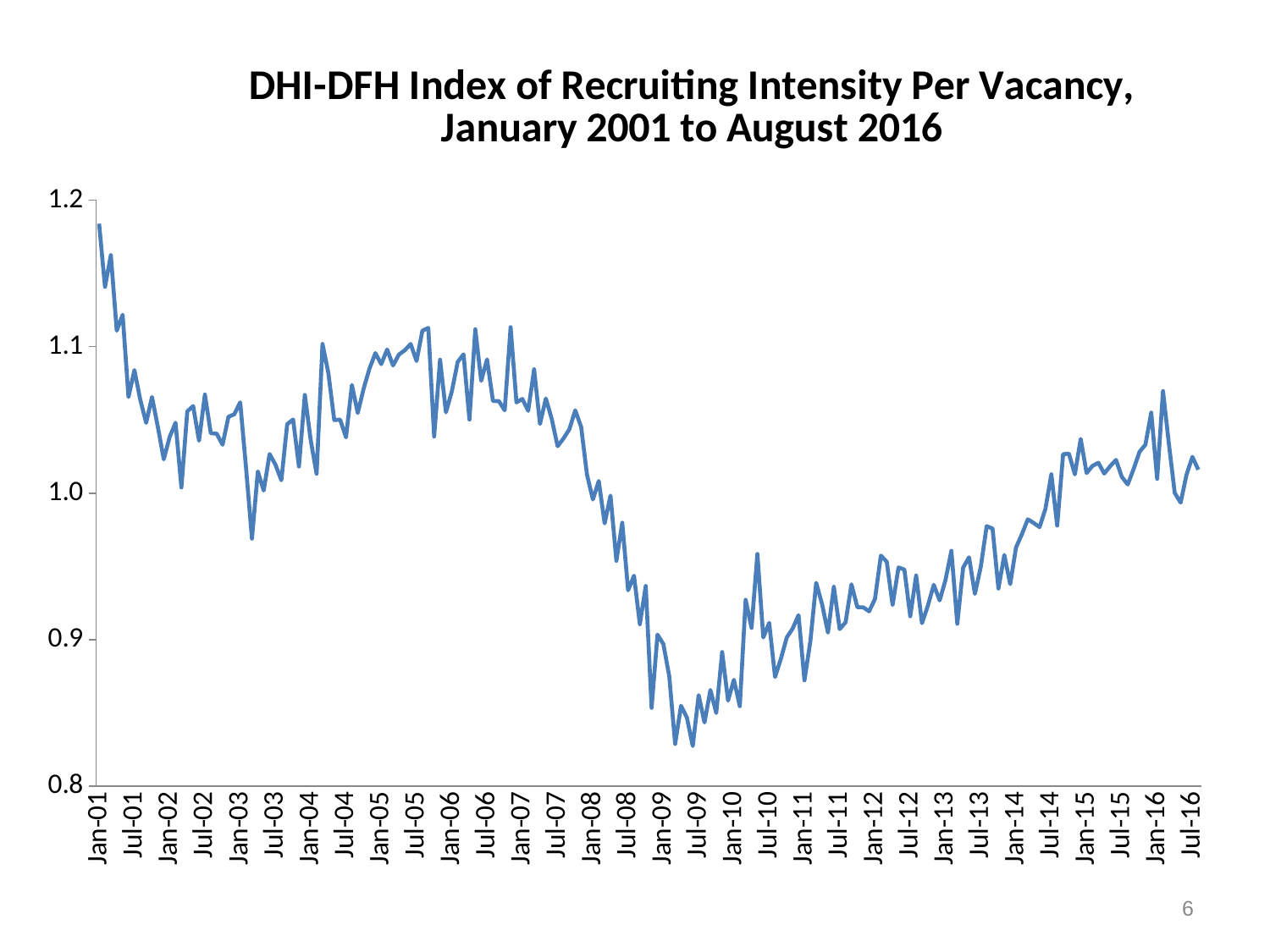
Is the value for Jan-01 greater or less than 1.1? greater Is the value for Jan-10 greater or less than 0.9? less Is the value for Jul-09 greater or less than 0.9? less Does the index rise or fall between Jan-08 and Jul-09? fall What is the lowest value shown on the vertical axis? 0.8 What kind of chart is shown on the slide? Line chart What is the title of the chart? DHI-DFH Index of Recruiting Intensity Per Vacancy, January 2001 to August 2016 Around which labelled date does the index reach its lowest point? Jul-09 Does the index generally rise or fall between Jul-09 and Jul-16? rise Which is larger, the value for Jan-01 or the value for Jul-09? Jan-01